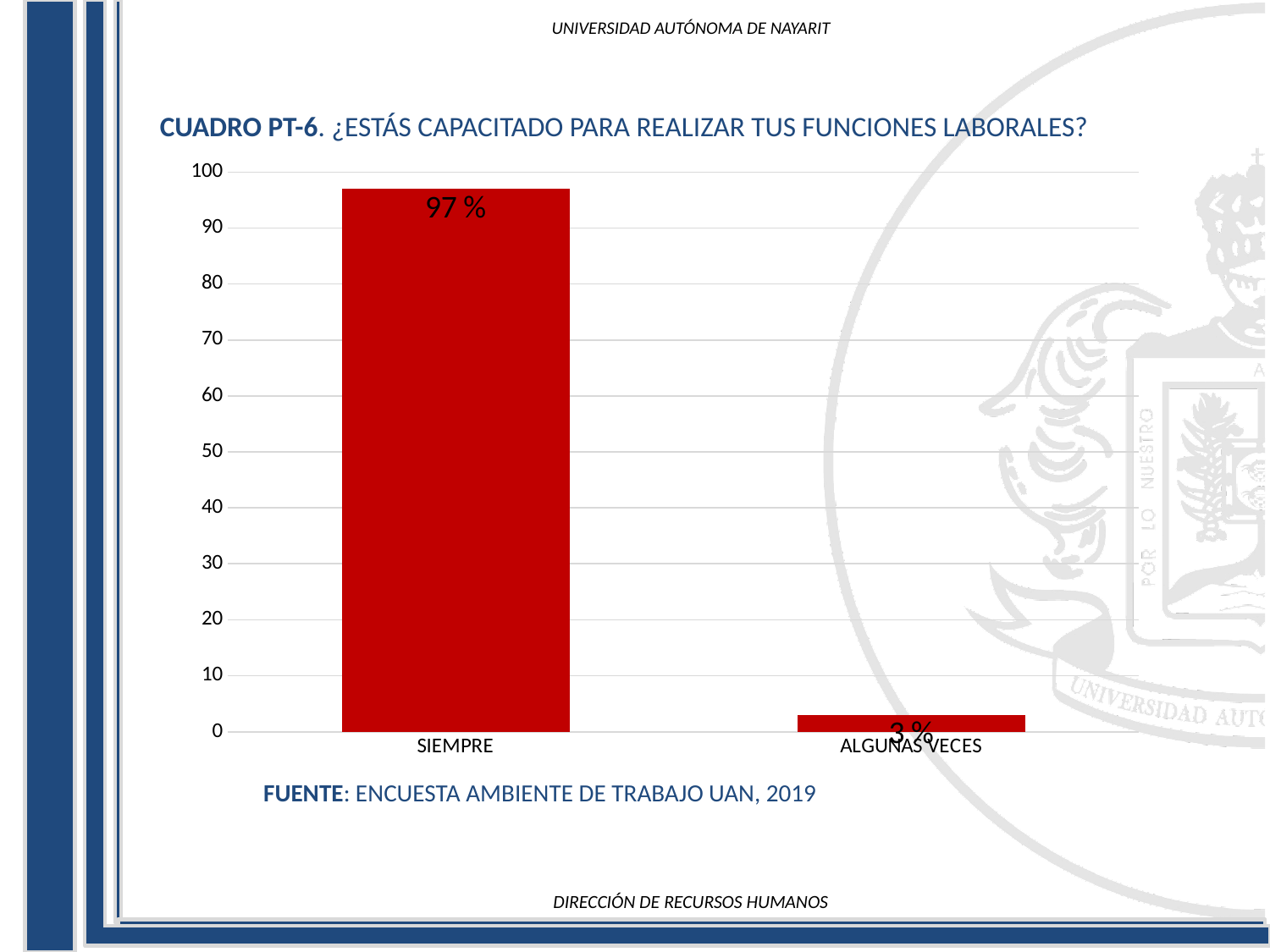
What colour are the bars in the chart? red How many categories are shown on the x axis? 2 What is the highest value shown on the y axis? 100 What kind of chart is shown on the slide? bar chart Is the value for SIEMPRE greater or less than 90? greater Which category has the lowest value? ALGUNAS VECES Which is larger, the value for SIEMPRE or the value for ALGUNAS VECES? SIEMPRE What is the value for ALGUNAS VECES? 3 % What is the value for SIEMPRE? 97 % Is the value for ALGUNAS VECES greater or less than 10? less What is the difference between the values for SIEMPRE and ALGUNAS VECES? 94 % Which category has the highest value? SIEMPRE